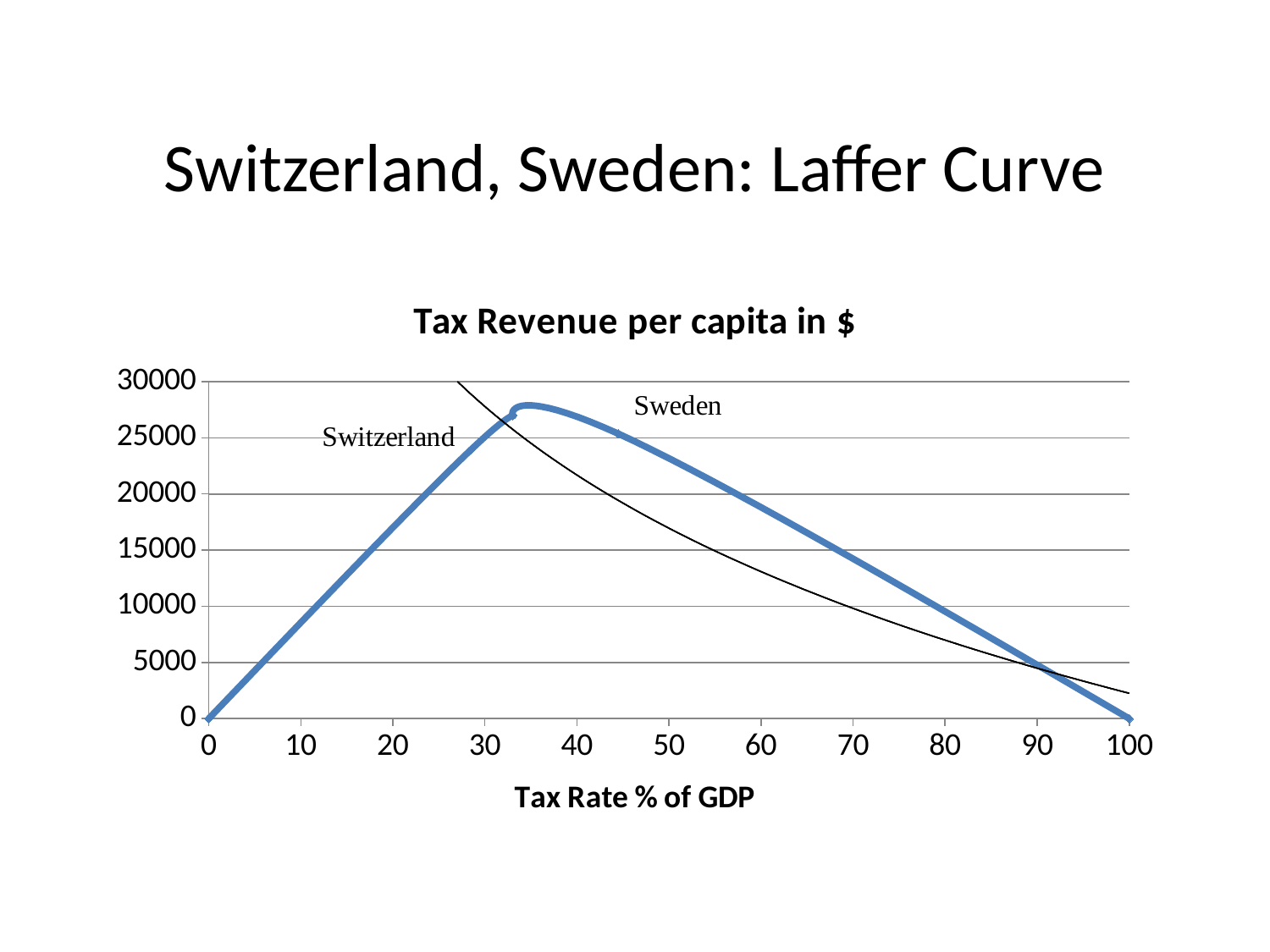
Which of the two values on the thick blue curve is larger: at a tax rate of 30 or at a tax rate of 80? 30 What is the title of the chart? Tax Revenue per capita in $ Does the thick blue curve rise or fall as the tax rate increases from 40 to 100? fall What is the tax revenue per capita on the thick blue curve at a tax rate of 0? 0 Is the value of the thick blue curve at a tax rate of 50 greater or less than 20000? greater Is the value of the thick blue curve at a tax rate of 40 greater or less than 25000? greater Is the value of the thick blue curve at a tax rate of 20 greater or less than 15000? greater What kind of chart is shown on the slide? line chart What is the label of the x axis? Tax Rate % of GDP What is the tax revenue per capita on the thick blue curve at a tax rate of 100? 0